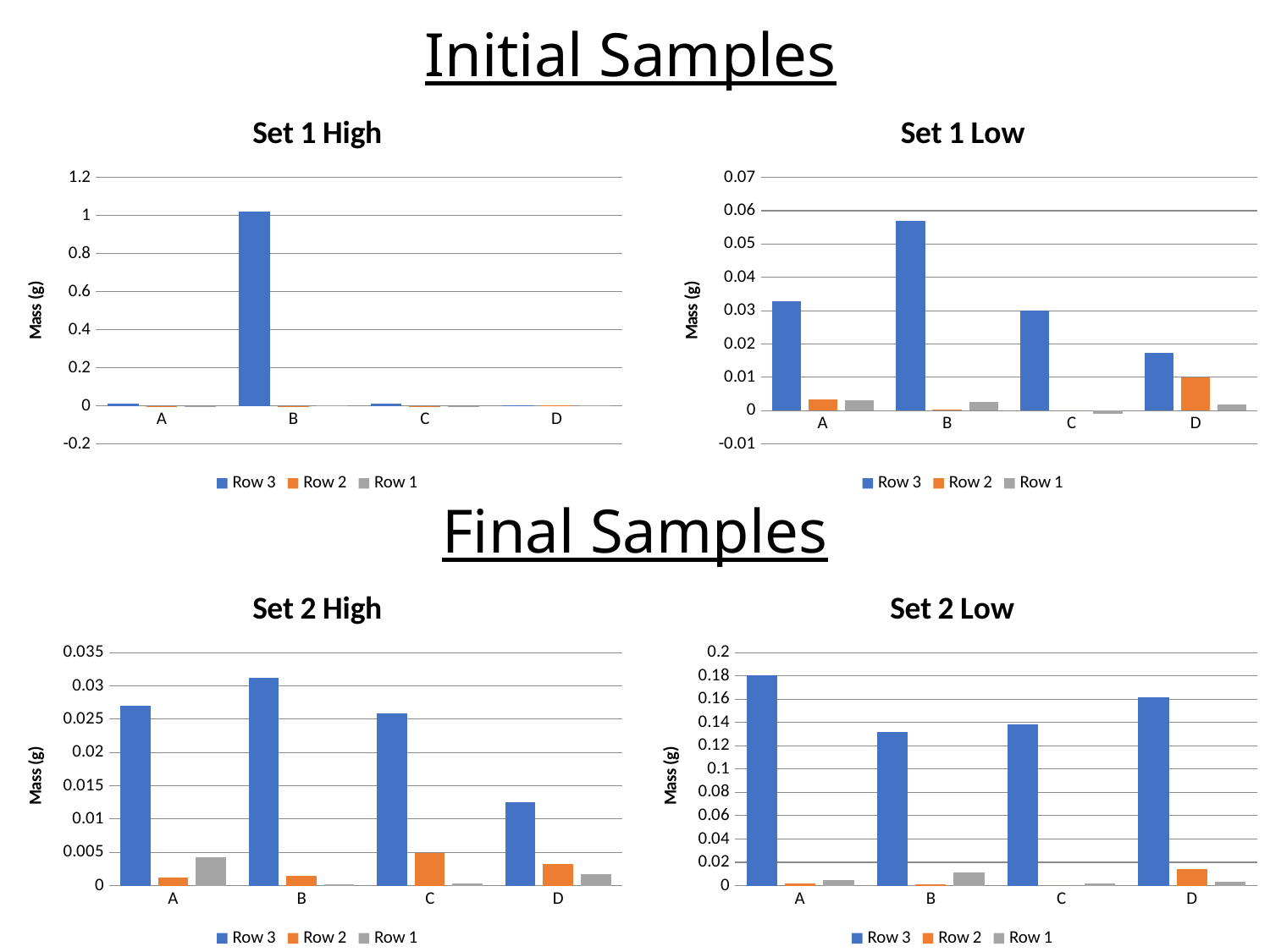
In the Set 2 Low chart, which category has the highest Row 3 value? A In the Set 1 High chart, is the Row 3 value for B greater or less than 0.8? greater In the Set 1 Low chart, which category has the highest Row 3 value? B How many series does the legend of the Set 2 Low chart list? 3 In the Set 2 High chart, which category has the lowest Row 3 value? D In the Set 1 High chart, which category has the highest Row 3 value? B In the Set 1 Low chart, which category has the lowest Row 3 value? D In the Set 2 High chart, is the Row 3 value for D greater or less than 0.015? less In the Set 1 Low chart, is the Row 3 value for B greater or less than 0.05? greater In the Set 2 Low chart, which is larger for Row 3: A or B? A What kind of chart is the Set 1 High chart? Bar chart